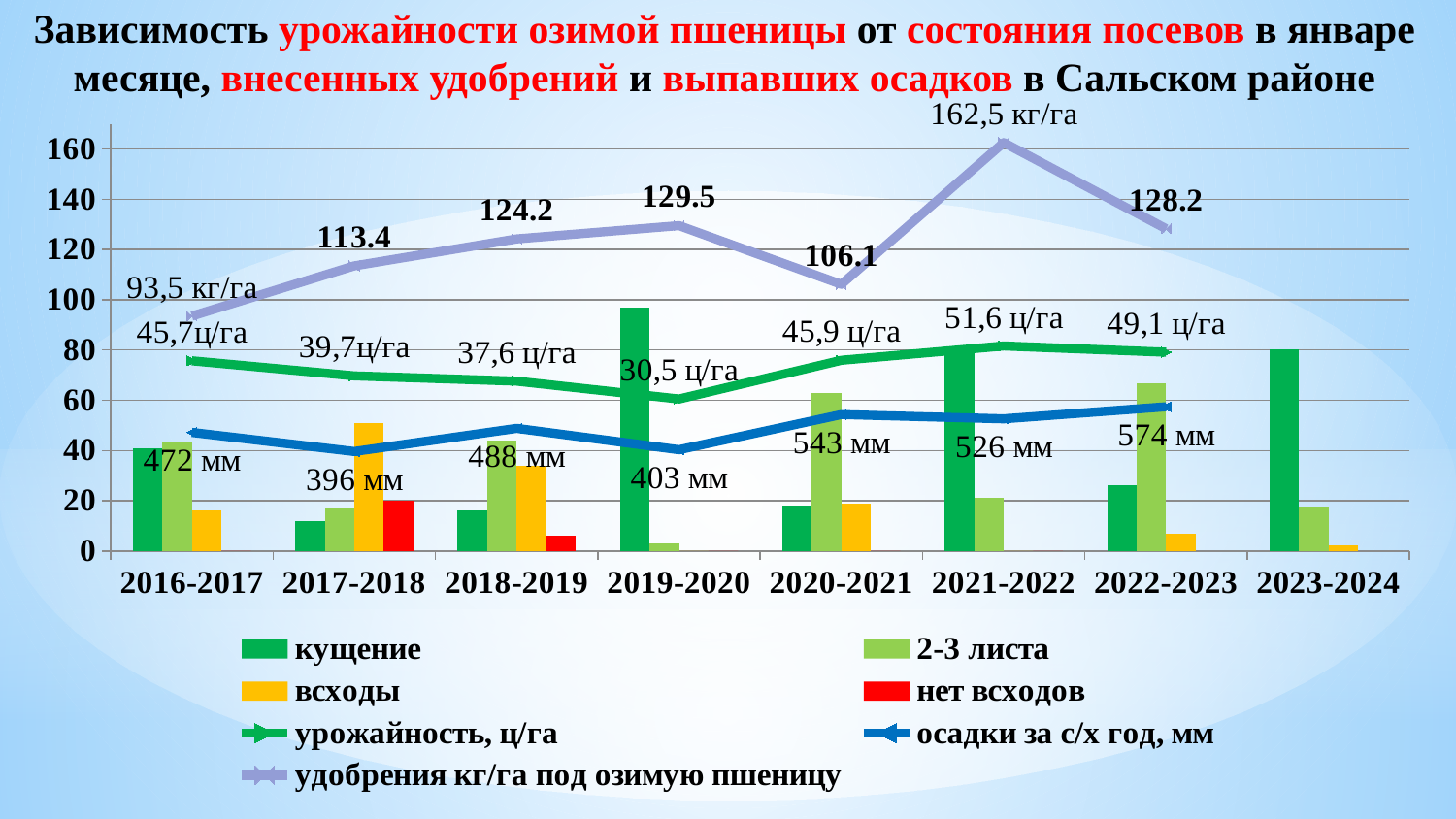
How many seasons are shown on the x axis? 8 What is the value of удобрения кг/га под озимую пшеницу for 2021-2022? 162,5 кг/га What is the урожайность value for 2019-2020? 30,5 ц/га How many series does the legend list? 7 In which season is the осадки за с/х год value the lowest? 2017-2018 What kind of chart is shown on the slide? Combined bar and line chart In which season is the урожайность value the lowest? 2019-2020 What is the difference between the урожайность values for 2021-2022 and 2019-2020? 21,1 ц/га What is the осадки за с/х год value for 2022-2023? 574 мм In which season is the удобрения кг/га под озимую пшеницу value the highest? 2021-2022 Is the кущение bar for 2019-2020 greater or less than 80? greater Which season has the larger осадки за с/х год value, 2020-2021 or 2021-2022? 2020-2021